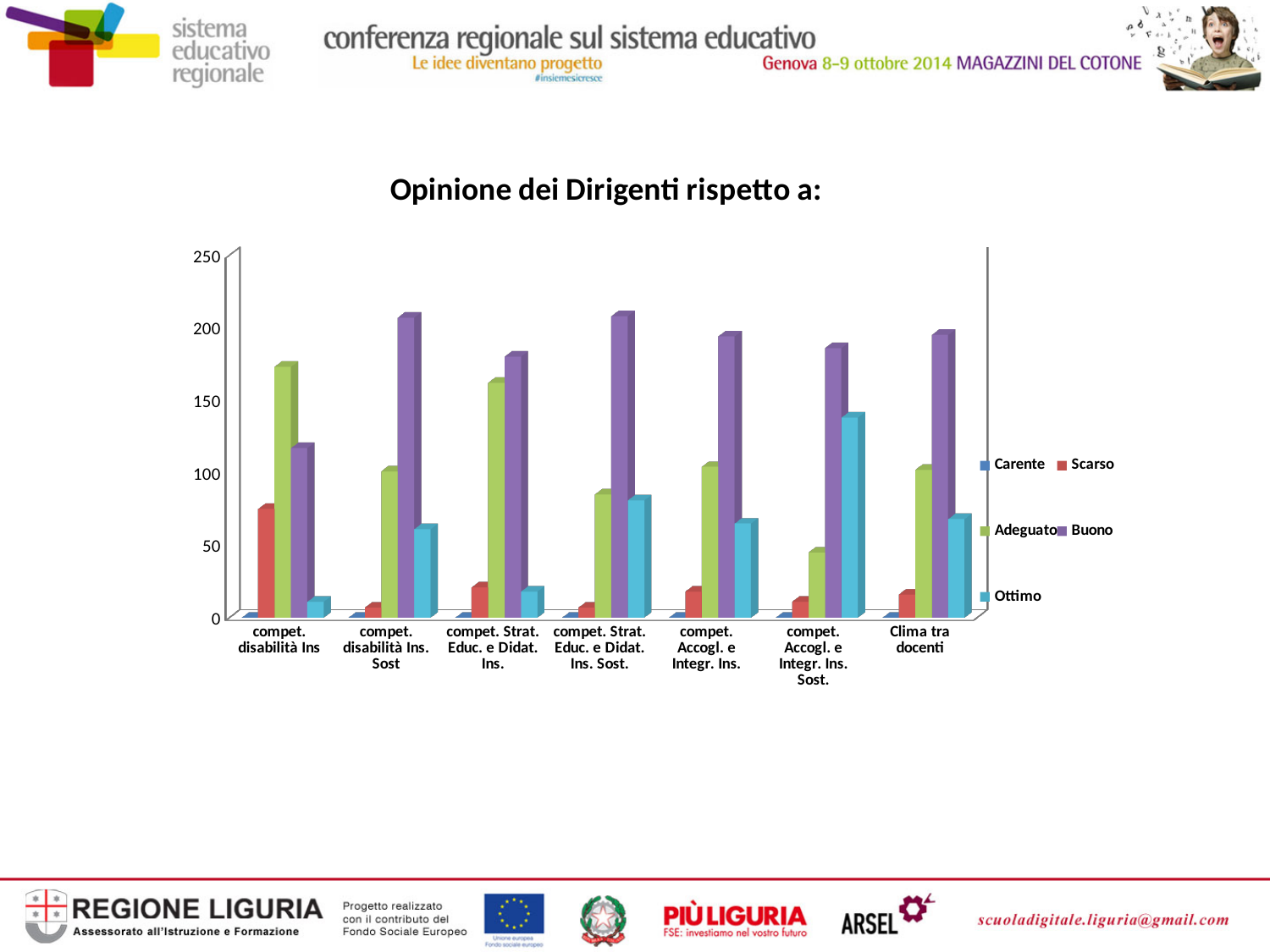
How many categories are shown on the x axis? 7 How many series does the legend list? 5 What is the title of the chart? Opinione dei Dirigenti rispetto a: Which category has the highest Adeguato value? compet. disabilità Ins Is the Scarso value for 'compet. disabilità Ins' greater or less than 50? greater Which category has the highest Ottimo value? compet. Accogl. e Integr. Ins. Sost. Is the Adeguato value for 'compet. disabilità Ins' greater or less than 150? greater For 'compet. disabilità Ins', which is larger: the Adeguato value or the Buono value? Adeguato Is the Buono value for 'compet. disabilità Ins' greater or less than 150? less Which series has the lowest value for 'Clima tra docenti'? Carente What kind of chart is shown on the slide? bar chart